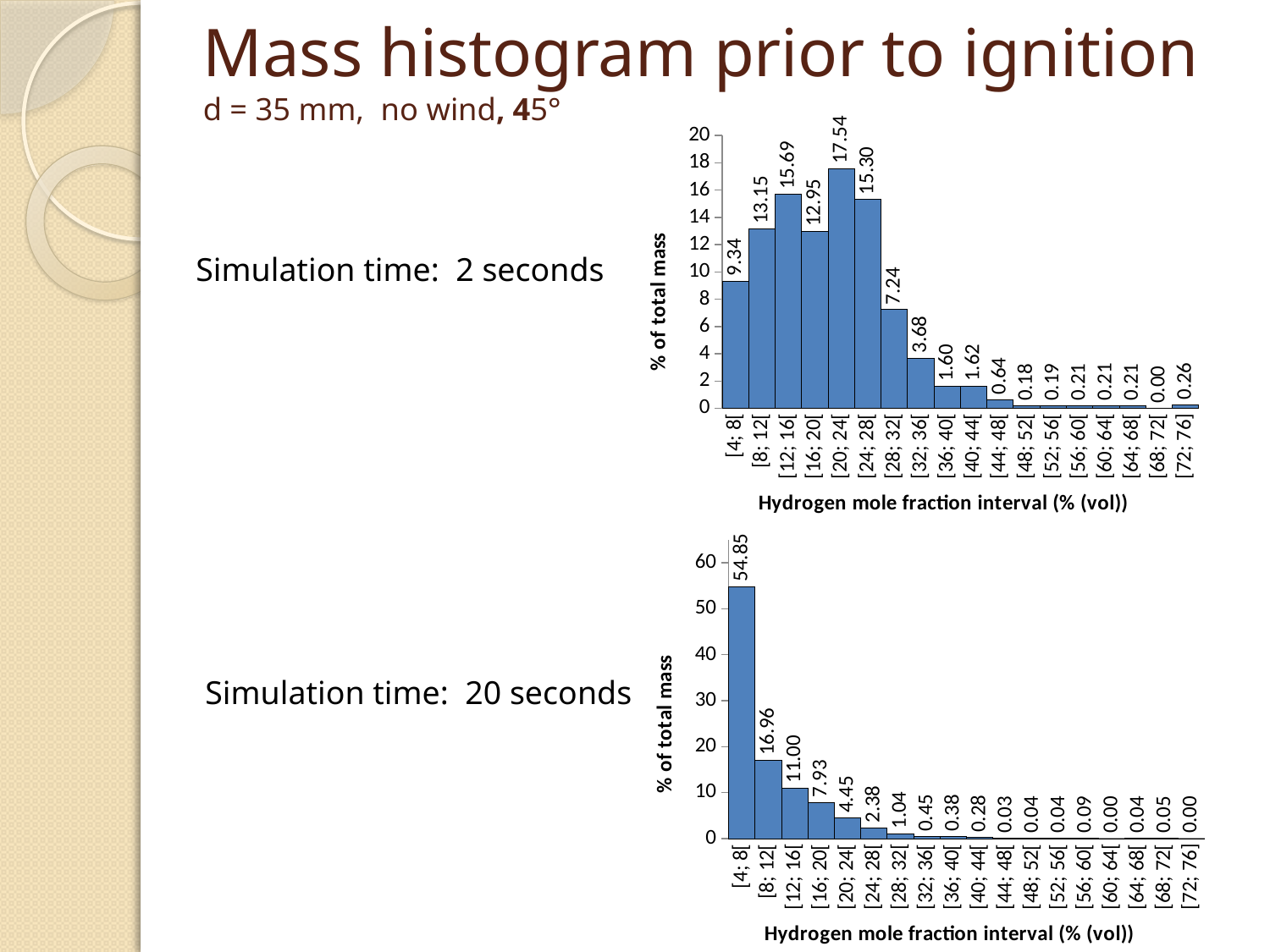
In the 20-second chart (bottom), do the values rise or fall as the hydrogen mole fraction interval increases from [4; 8[ to [28; 32[? fall In the 20-second chart (bottom), what is the value for the [4; 8[ interval? 54.85 In the 2-second chart (top), what is the value for the [20; 24[ interval? 17.54 In the 2-second chart (top), which is larger: the value for [8; 12[ or the value for [16; 20[? [8; 12[ What kind of chart is used for the 20-second simulation (bottom)? bar chart In the 2-second chart (top), what is the difference between the values for [20; 24[ and [24; 28[? 2.24 In the 2-second chart (top), which interval has the highest % of total mass? [20; 24[ In the 2-second chart (top), is the value for [28; 32[ greater or less than 8? less In the 20-second chart (bottom), what is the value for the [12; 16[ interval? 11.00 In the 2-second chart (top), how many intervals are shown on the x axis? 18 What is the x-axis label of the 2-second chart (top)? Hydrogen mole fraction interval (% (vol)) In the 20-second chart (bottom), what is the difference between the values for [4; 8[ and [8; 12[? 37.89